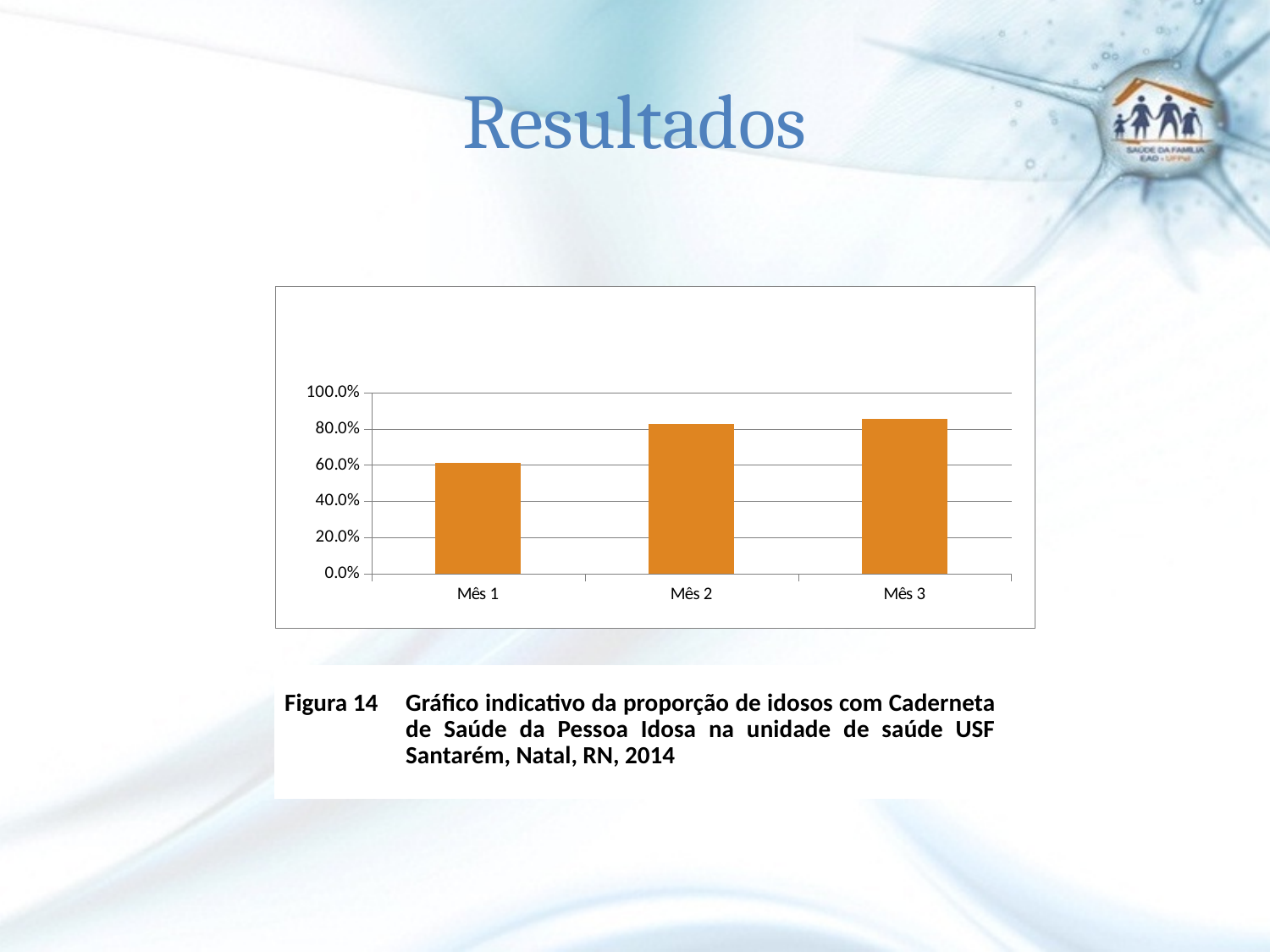
How many categories (months) are plotted on the chart? 3 Is the value for Mês 1 greater or less than 40.0%? greater Is the value for Mês 1 greater or less than 80.0%? less Is the value for Mês 3 greater or less than 80.0%? greater Do the values rise or fall from Mês 1 to Mês 3? rise What colour are the bars in the chart? orange What kind of chart is shown on the slide? bar chart Which is larger, the value for Mês 1 or the value for Mês 2? Mês 2 Which month has the lowest value on the chart? Mês 1 What is the highest value shown on the vertical axis? 100.0%